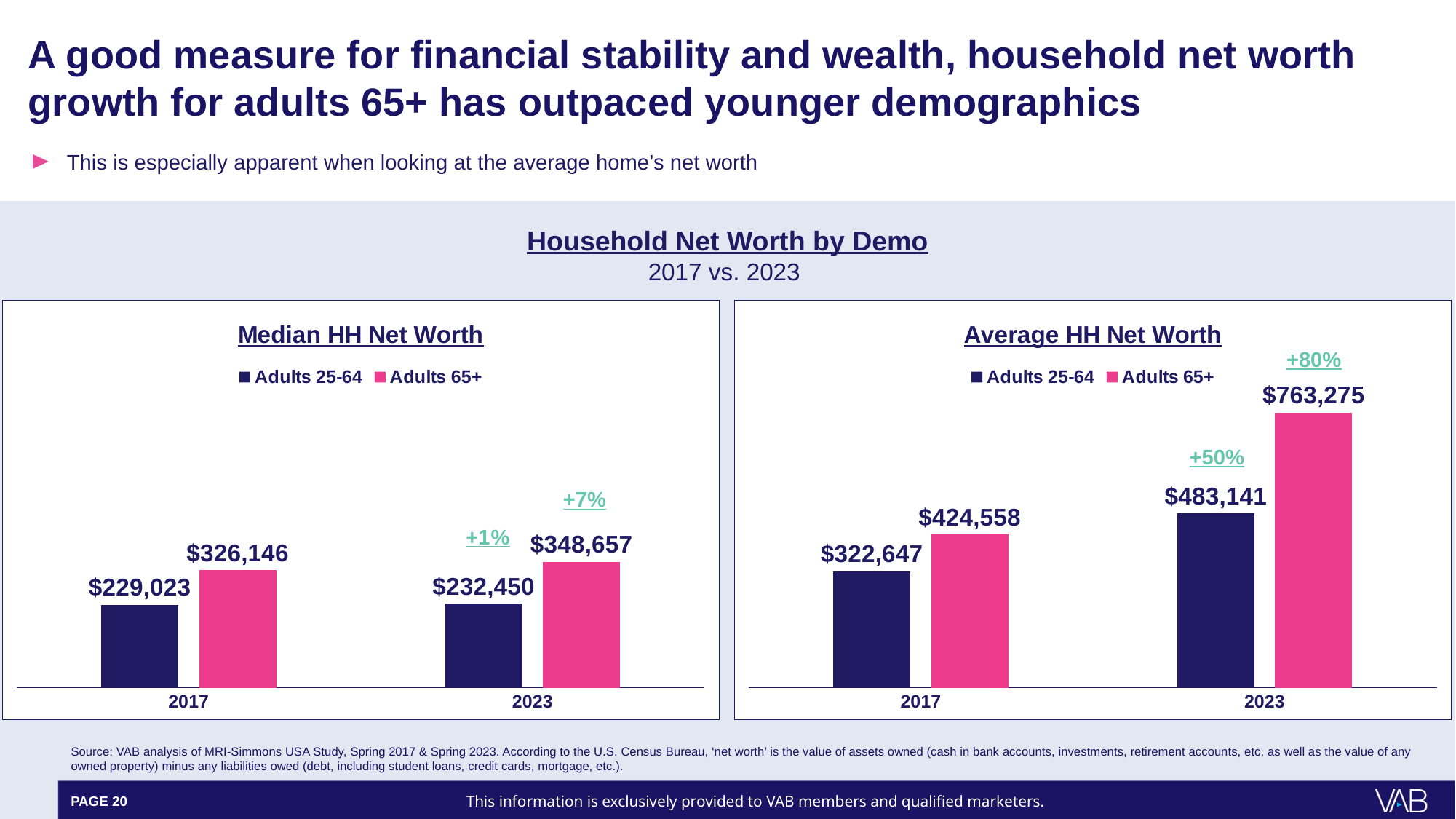
In the Average HH Net Worth chart, which bar is the highest? Adults 65+ in 2023 In the Average HH Net Worth chart, which is larger in 2023: Adults 25-64 or Adults 65+? Adults 65+ In the Median HH Net Worth chart, what is the value for Adults 65+ in 2017? $326,146 What kind of chart is the Average HH Net Worth chart? Bar chart In the Average HH Net Worth chart, what is the value for Adults 25-64 in 2017? $322,647 In the Average HH Net Worth chart, what is the value for Adults 65+ in 2023? $763,275 How many series does the legend of the Median HH Net Worth chart list? 2 In the Median HH Net Worth chart, what is the difference between Adults 65+ and Adults 25-64 in 2023? $116,207 In the Median HH Net Worth chart, what is the value for Adults 25-64 in 2023? $232,450 In the Median HH Net Worth chart, which bar is the lowest? Adults 25-64 in 2017 In the Average HH Net Worth chart, what is the difference between Adults 65+ and Adults 25-64 in 2017? $101,911 In the Average HH Net Worth chart, what percentage growth is shown above the Adults 65+ bar for 2023? +80%